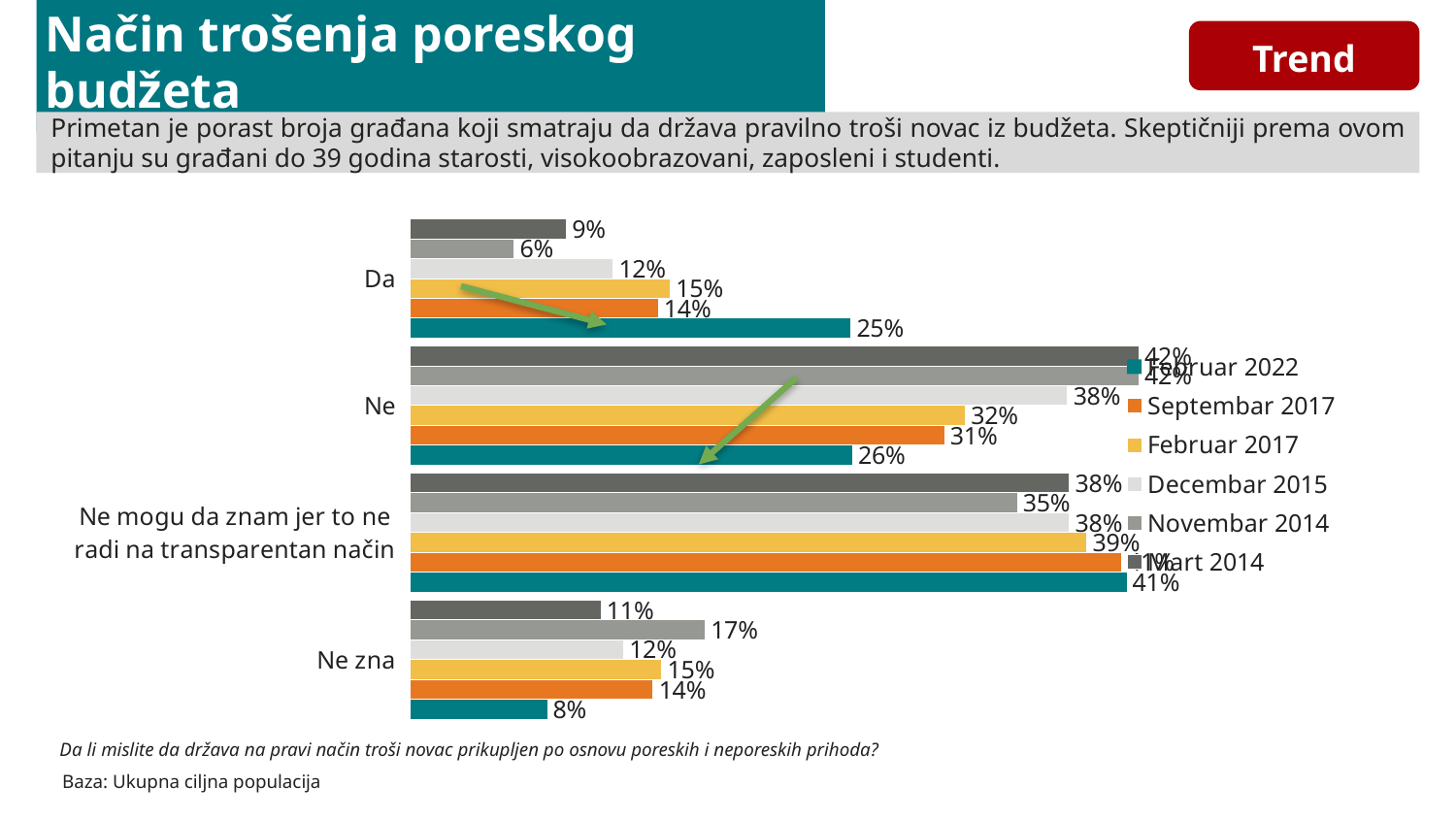
How many answer categories are shown on the chart? 4 What is the value for Decembar 2015 in the 'Ne' category? 38% What is the value for Novembar 2014 in the 'Ne zna' category? 17% In the 'Ne' category, which is larger: the Mart 2014 value or the Februar 2022 value? Mart 2014 What is the value for Februar 2022 in the 'Da' category? 25% Which category has the lowest value for Februar 2022? Ne zna What kind of chart is shown on the slide? Bar chart What is the value for Februar 2017 in the 'Ne zna' category? 15% How many series does the legend list? 6 Which category has the highest value for Februar 2022? Ne mogu da znam jer to ne radi na transparentan način In the 'Da' category, what is the difference between the Februar 2022 value and the Septembar 2017 value? 11 percentage points Do the values for the 'Ne' category rise or fall from Mart 2014 to Februar 2022? Fall